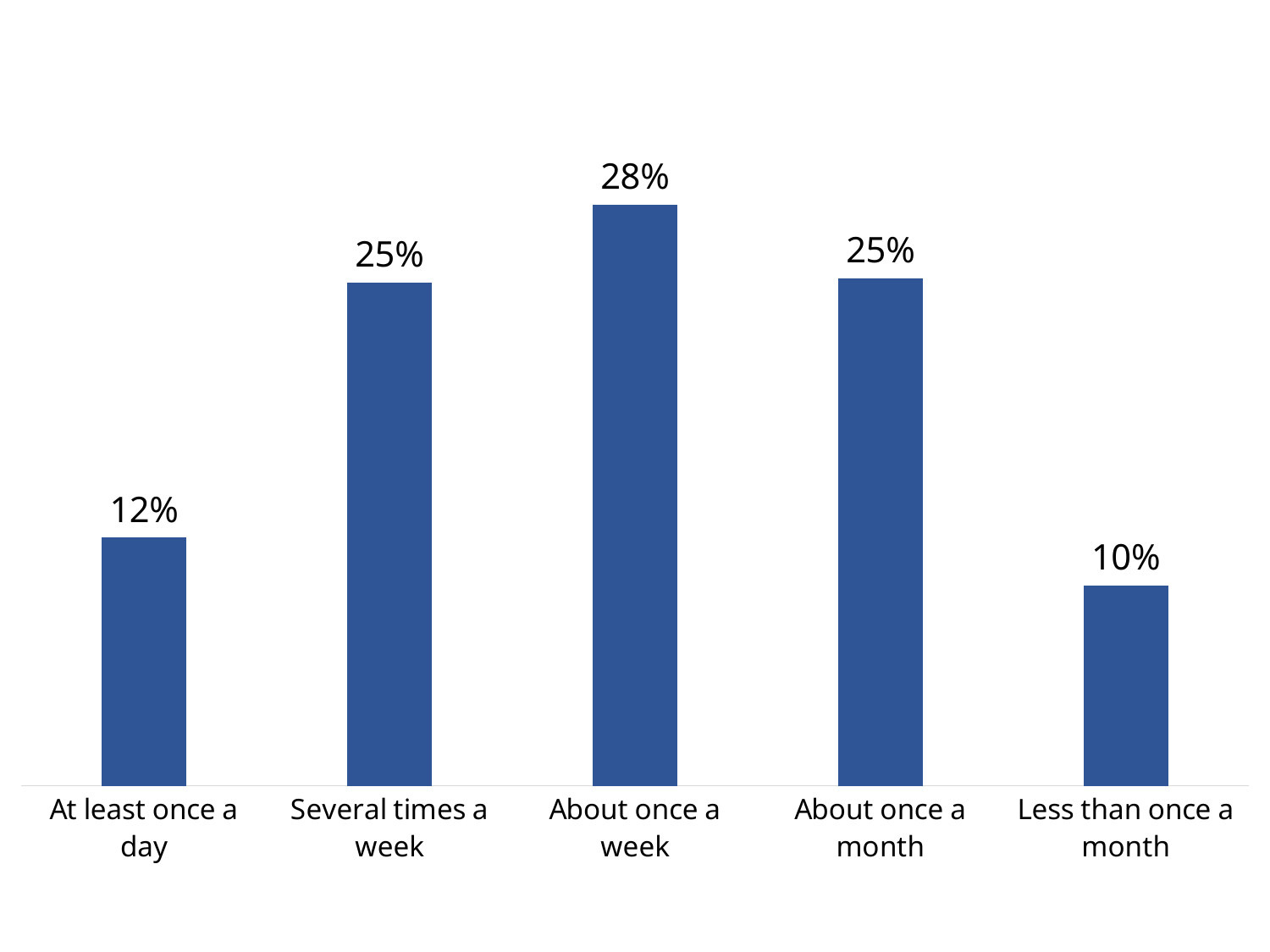
What colour are the bars in the chart? Blue What is the value for "At least once a day"? 12% What kind of chart is shown on the slide? Bar chart How many categories are shown on the chart? 5 Which is larger, the value for "Several times a week" or the value for "At least once a day"? Several times a week What is the value for "Several times a week"? 25% What is the difference between the values for "At least once a day" and "Less than once a month"? 2% What is the value for "About once a week"? 28% What is the value for "Less than once a month"? 10% Which category has the lowest value? Less than once a month What is the difference between the values for "About once a week" and "About once a month"? 3% Which category has the highest value? About once a week